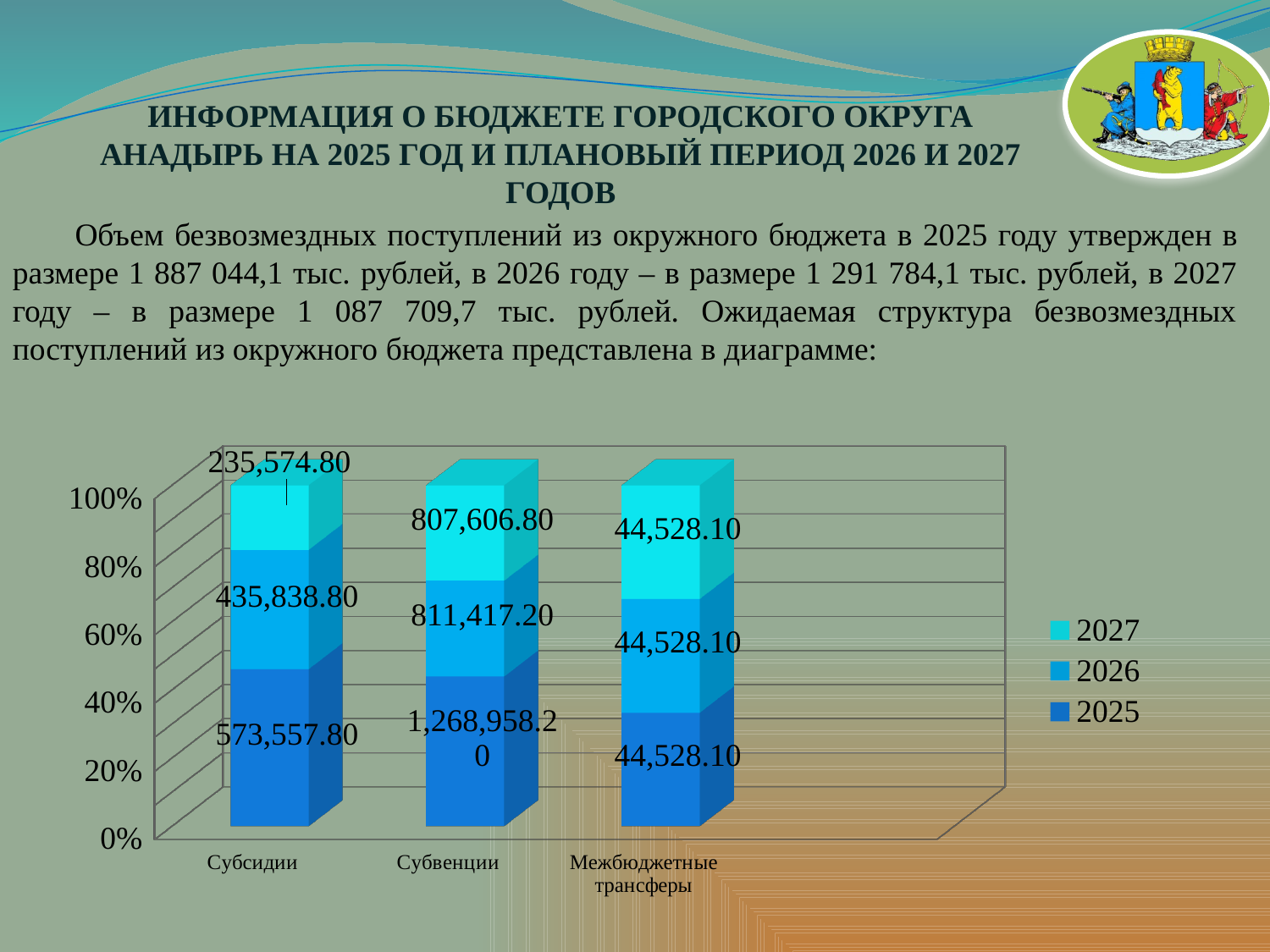
Which category has the lowest value in the 2027 series? Межбюджетные трансферы What kind of chart is shown on the slide? Stacked bar chart What is the value for Субвенции in the 2026 series? 811,417.20 What is the total of the three stacked values for Субсидии? 1,244,971.40 What is the value for Субсидии in the 2025 series? 573,557.80 What is the value for Межбюджетные трансферы in the 2027 series? 44,528.10 How many series does the legend list? 3 What is the difference between the 2025 and 2026 values for Субсидии? 137,719.00 What is the value for Субсидии in the 2027 series? 235,574.80 Which is larger: the 2027 value for Субсидии or the 2027 value for Субвенции? Субвенции How many categories are shown on the x axis? 3 Which category has the highest value in the 2025 series? Субвенции